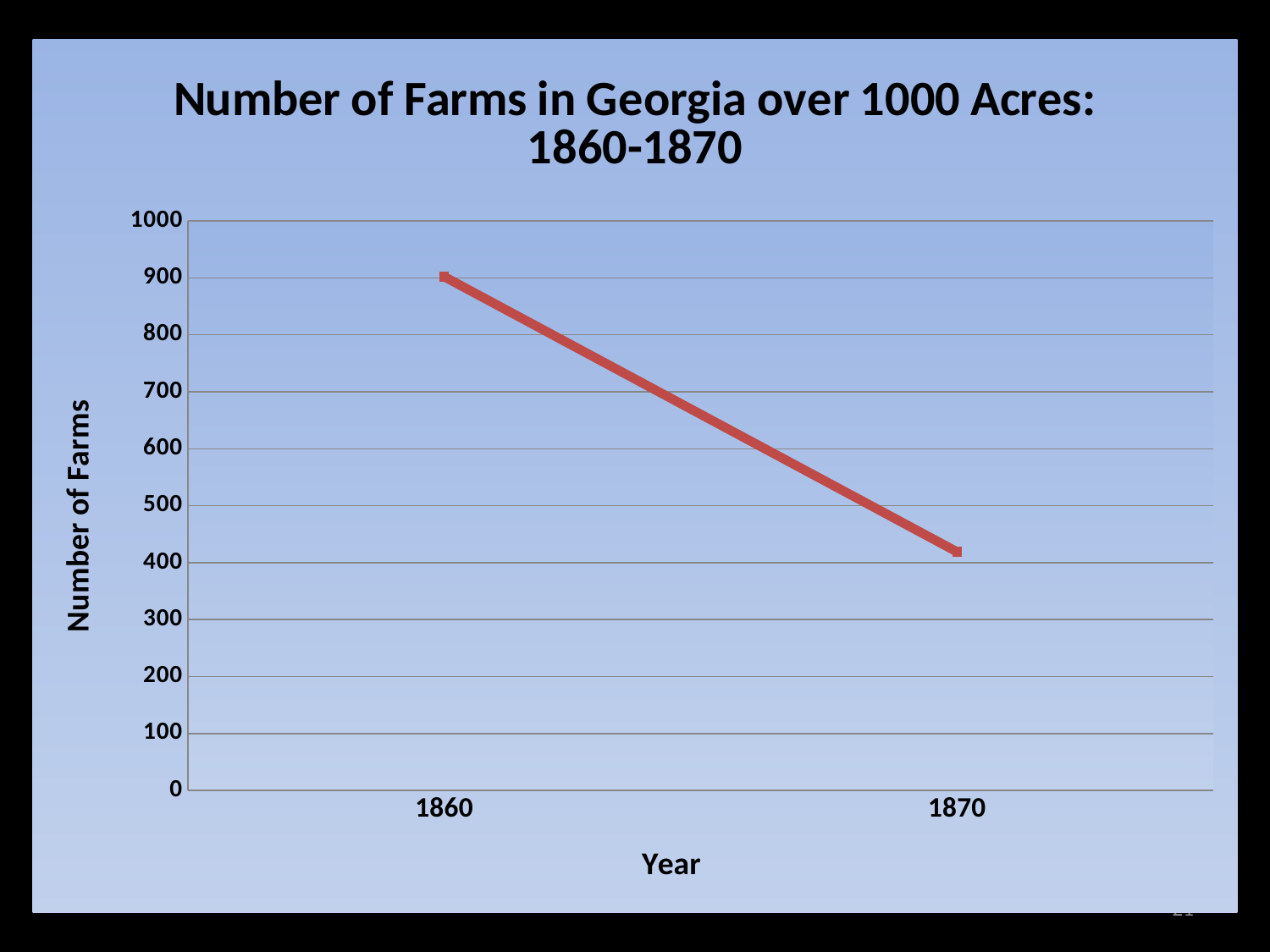
Does the number of farms rise or fall from 1860 to 1870? fall Is the value for 1870 greater or less than 500? less How many years are plotted on the x axis? 2 Which year has the lowest number of farms over 1000 acres? 1870 Which year has the highest number of farms over 1000 acres? 1860 Is the value for 1860 greater or less than 800? greater Is the value for 1870 greater or less than 400? greater What is the label of the vertical axis? Number of Farms What kind of chart is shown on the slide? line chart Which year has the higher number of farms over 1000 acres, 1860 or 1870? 1860 What is the title of the chart? Number of Farms in Georgia over 1000 Acres: 1860-1870